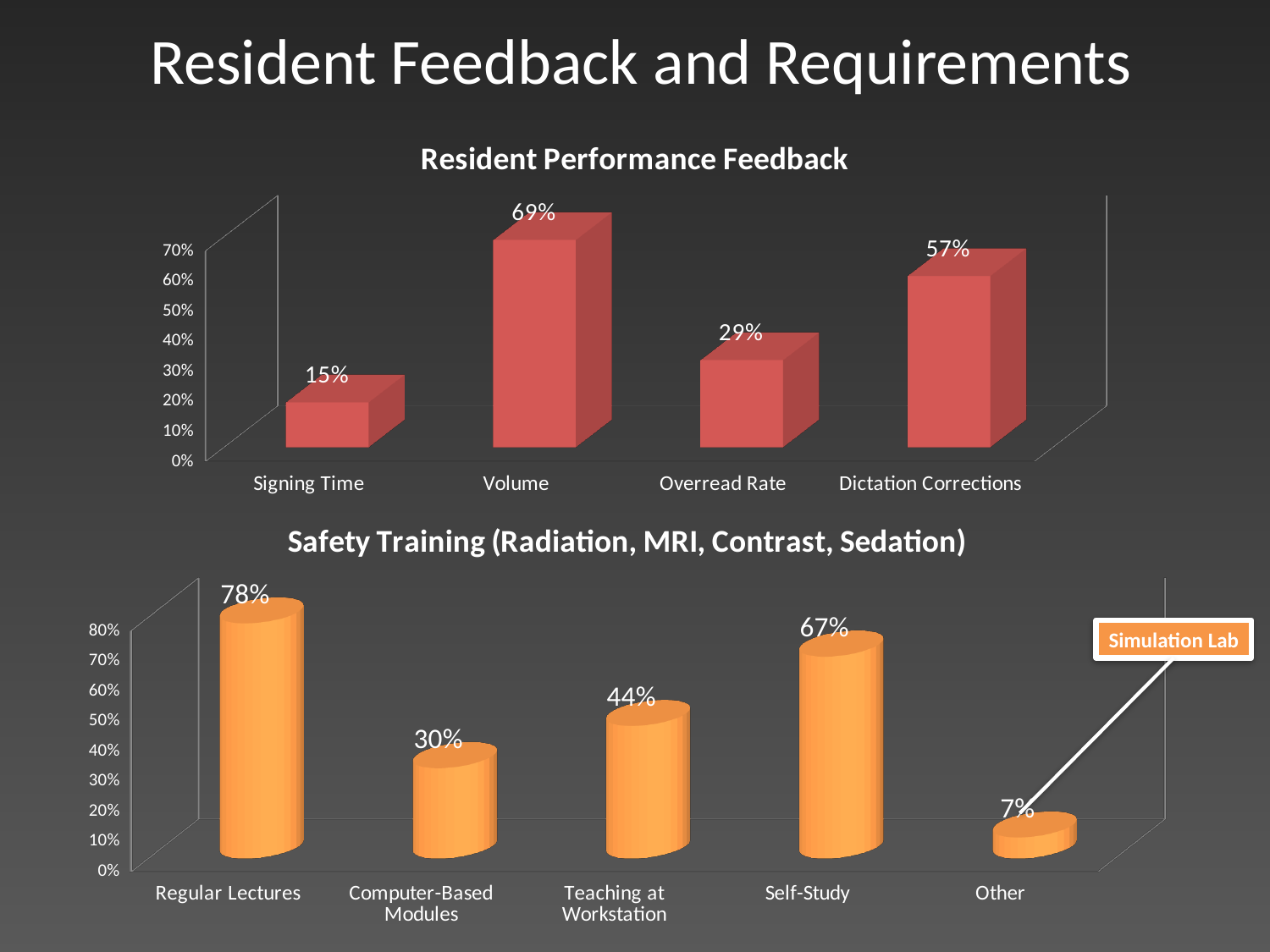
In the Resident Performance Feedback chart, what is the value for Volume? 69% In the Safety Training (Radiation, MRI, Contrast, Sedation) chart, how many categories are shown? 5 What kind of chart is the Safety Training (Radiation, MRI, Contrast, Sedation) chart? Bar chart In the Safety Training (Radiation, MRI, Contrast, Sedation) chart, what is the value for Self-Study? 67% In the Resident Performance Feedback chart, which is larger, Overread Rate or Dictation Corrections? Dictation Corrections In the Safety Training (Radiation, MRI, Contrast, Sedation) chart, which category has the highest value? Regular Lectures In the Resident Performance Feedback chart, which category has the lowest value? Signing Time In the Safety Training (Radiation, MRI, Contrast, Sedation) chart, what does the callout label attached to the Other bar say? Simulation Lab In the Safety Training (Radiation, MRI, Contrast, Sedation) chart, what is the difference between Regular Lectures and Computer-Based Modules? 48% In the Resident Performance Feedback chart, what is the difference between Volume and Dictation Corrections? 12% In the Safety Training (Radiation, MRI, Contrast, Sedation) chart, what is the value for Other? 7% In the Resident Performance Feedback chart, how many categories are shown? 4